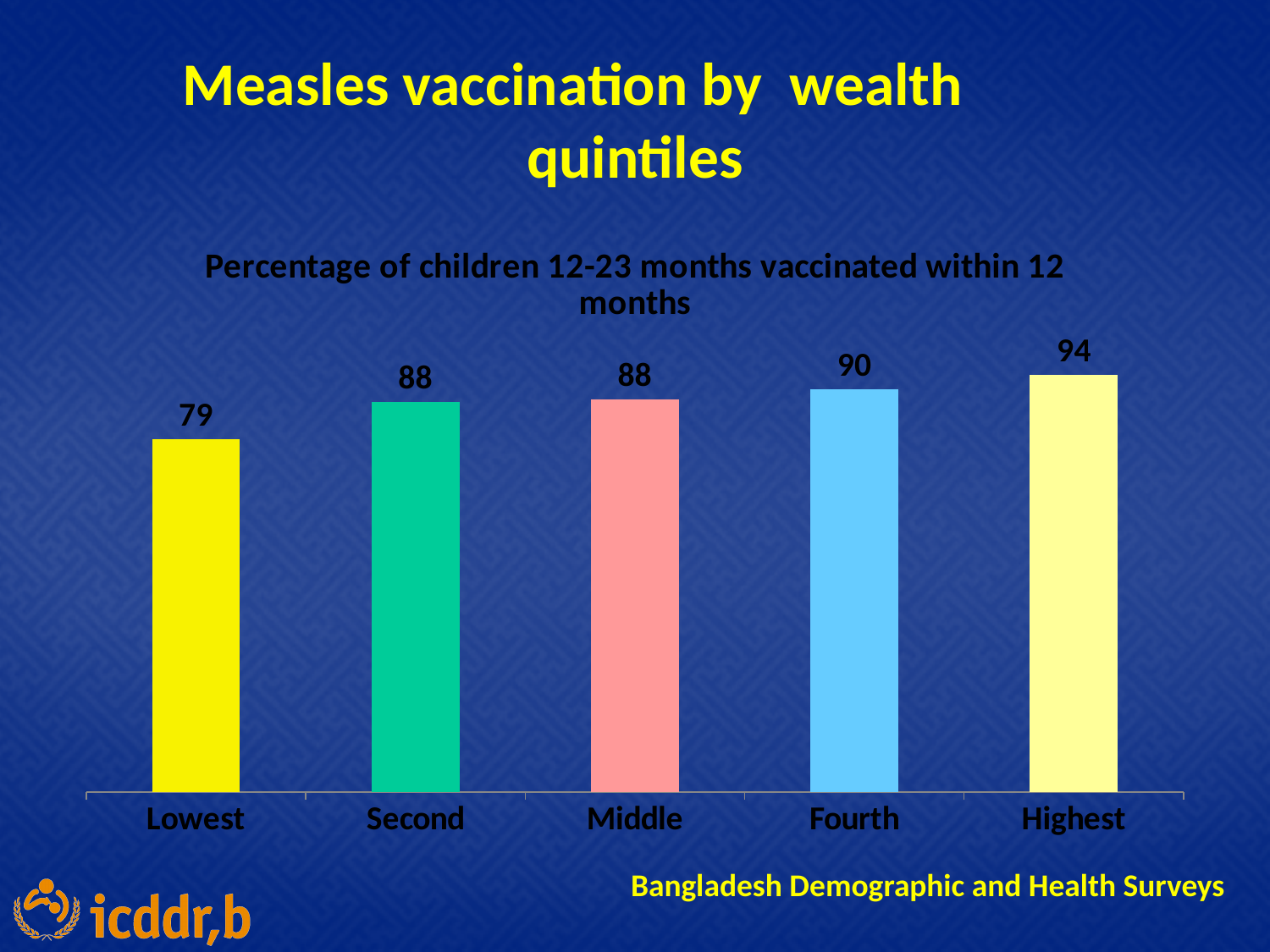
Which wealth quintile has the lowest percentage of children vaccinated? Lowest What is the difference between the values for the Highest and Lowest quintiles? 15 What is the title of the chart? Percentage of children 12-23 months vaccinated within 12 months What is the value for the Lowest wealth quintile? 79 How many wealth quintile categories are shown in the chart? 5 What is the value for the Highest wealth quintile? 94 Do the values generally rise or fall from the Lowest to the Highest quintile? Rise What is the value for the Fourth wealth quintile? 90 What is the difference between the values for the Fourth and Second quintiles? 2 What kind of chart is shown on the slide? Bar chart Which is larger, the value for the Fourth quintile or the value for the Middle quintile? Fourth Which wealth quintile has the highest percentage of children vaccinated? Highest